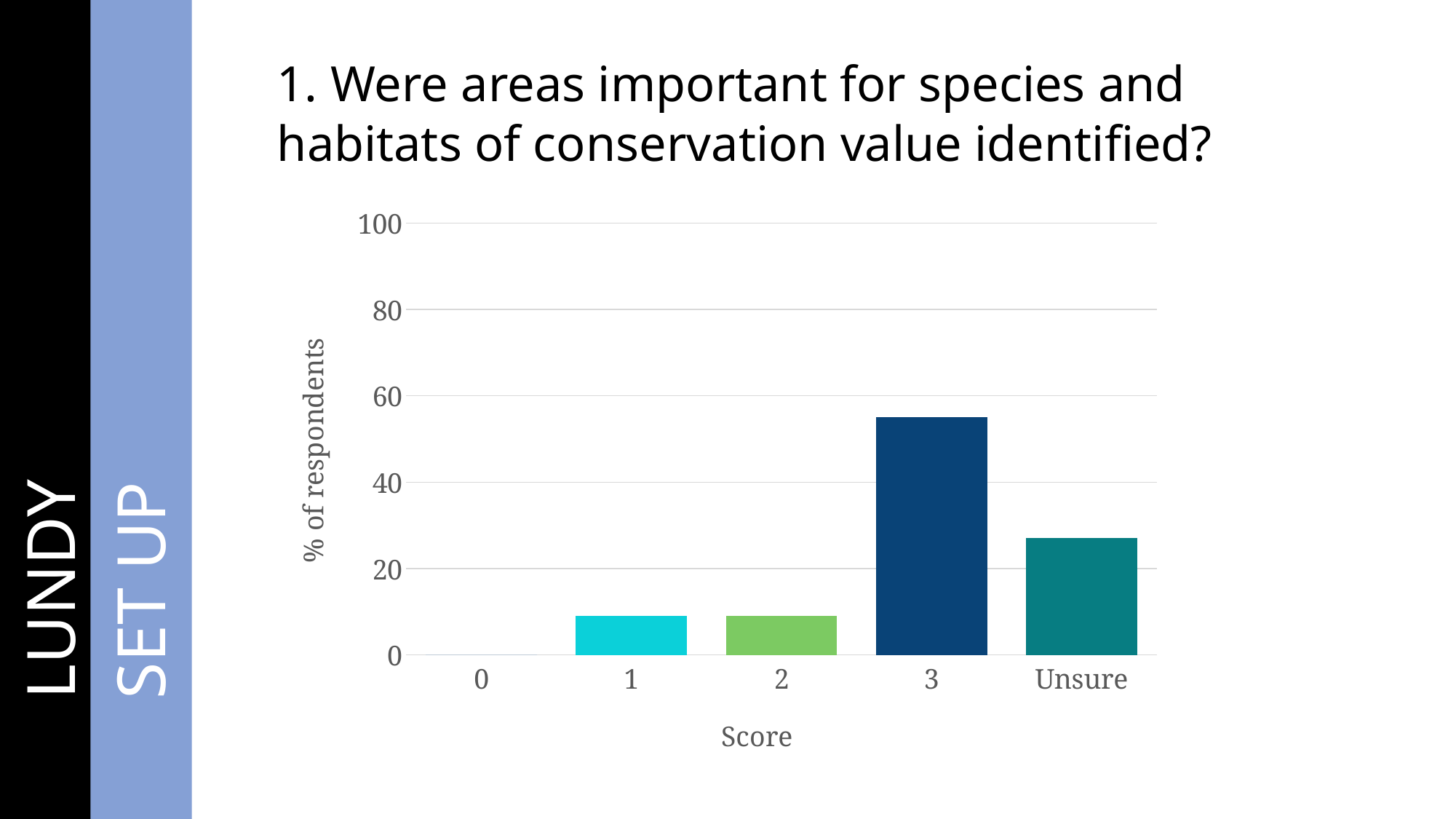
Which has a larger percentage of respondents, score 3 or Unsure? 3 Is the value for score 3 greater or less than 40? greater What is the label of the y axis? % of respondents Which score category has the highest percentage of respondents? 3 What kind of chart is shown on the slide? bar chart What is the label of the x axis? Score How many score categories are shown on the x axis? 5 Is the value for Unsure greater or less than 40? less Is the value for score 3 greater or less than 60? less Which score category has the lowest percentage of respondents? 0